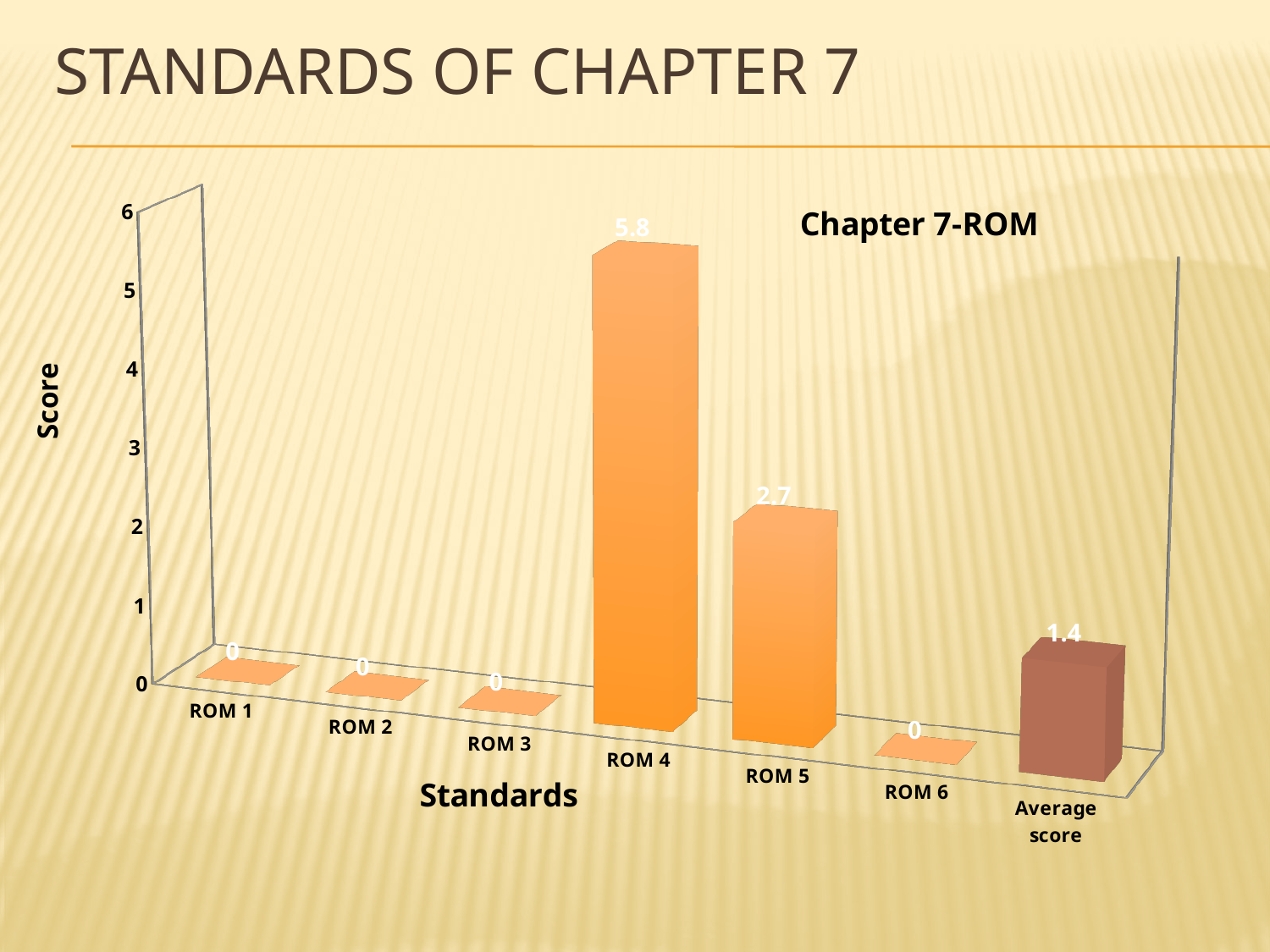
How many categories are shown on the x axis? 7 How many standards (ROM 1 to ROM 6) have a score of 0? 4 What is the score for ROM 4? 5.8 What kind of chart is shown on the slide? Bar chart What is the score for ROM 2? 0 What is the score for ROM 5? 2.7 What is the difference between the scores for ROM 4 and ROM 5? 3.1 What is the title of the chart? Chapter 7-ROM Which standard has the highest score? ROM 4 Which is larger, the score for ROM 5 or the Average score? ROM 5 What is the value shown for Average score? 1.4 Is the score for ROM 4 greater or less than 5? greater